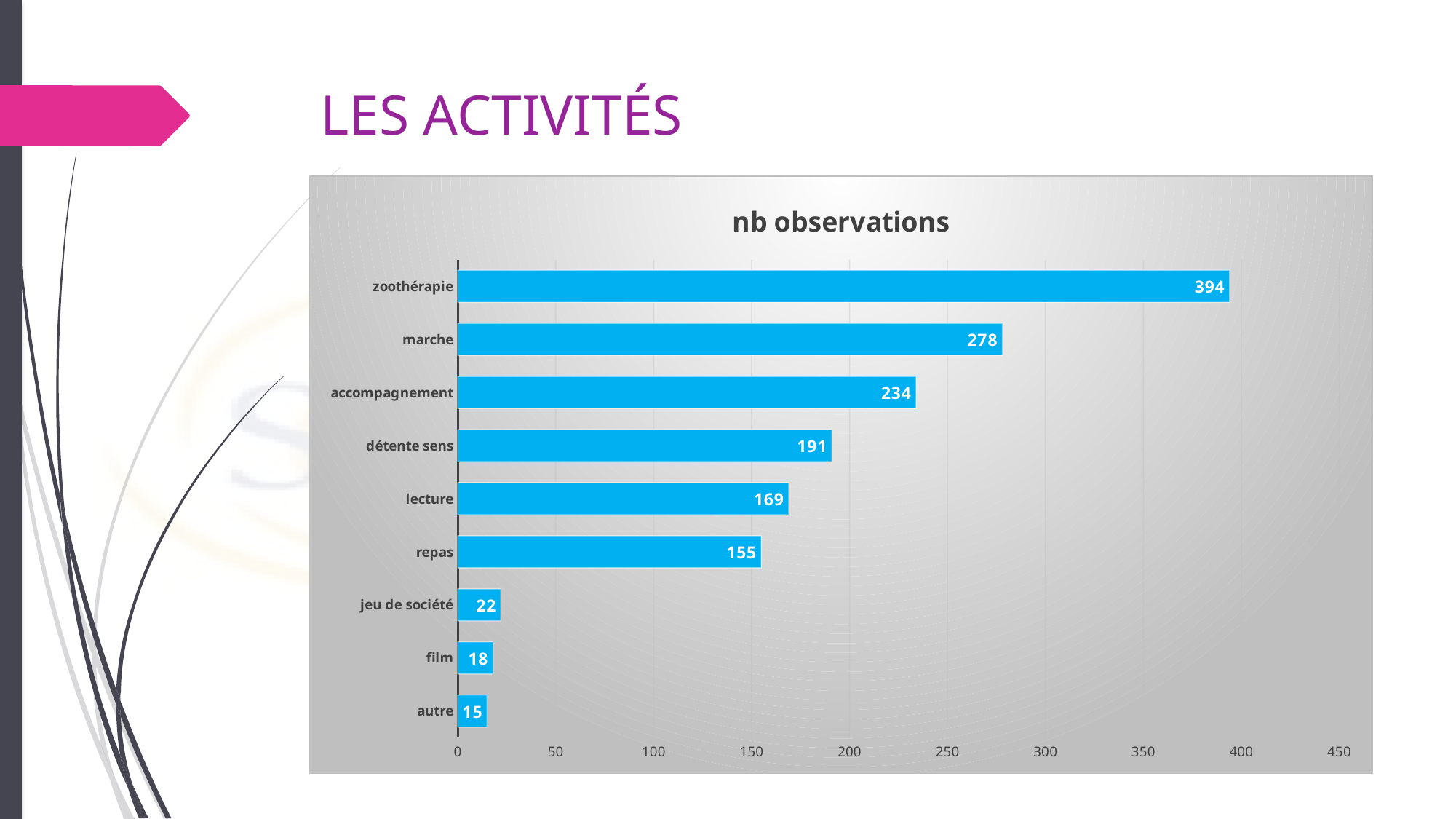
Which is larger, the value for repas or the value for détente sens? détente sens How many categories are shown in the chart? 9 What is the difference between the values for marche and accompagnement? 44 Is the value for accompagnement greater or less than 200? greater What is the value for zoothérapie? 394 What kind of chart is shown on the slide? bar chart What is the value for film? 18 Which category has the lowest number of observations? autre What is the difference between the values for jeu de société and autre? 7 Which category has the highest number of observations? zoothérapie What is the value for lecture? 169 What is the title of the chart? nb observations